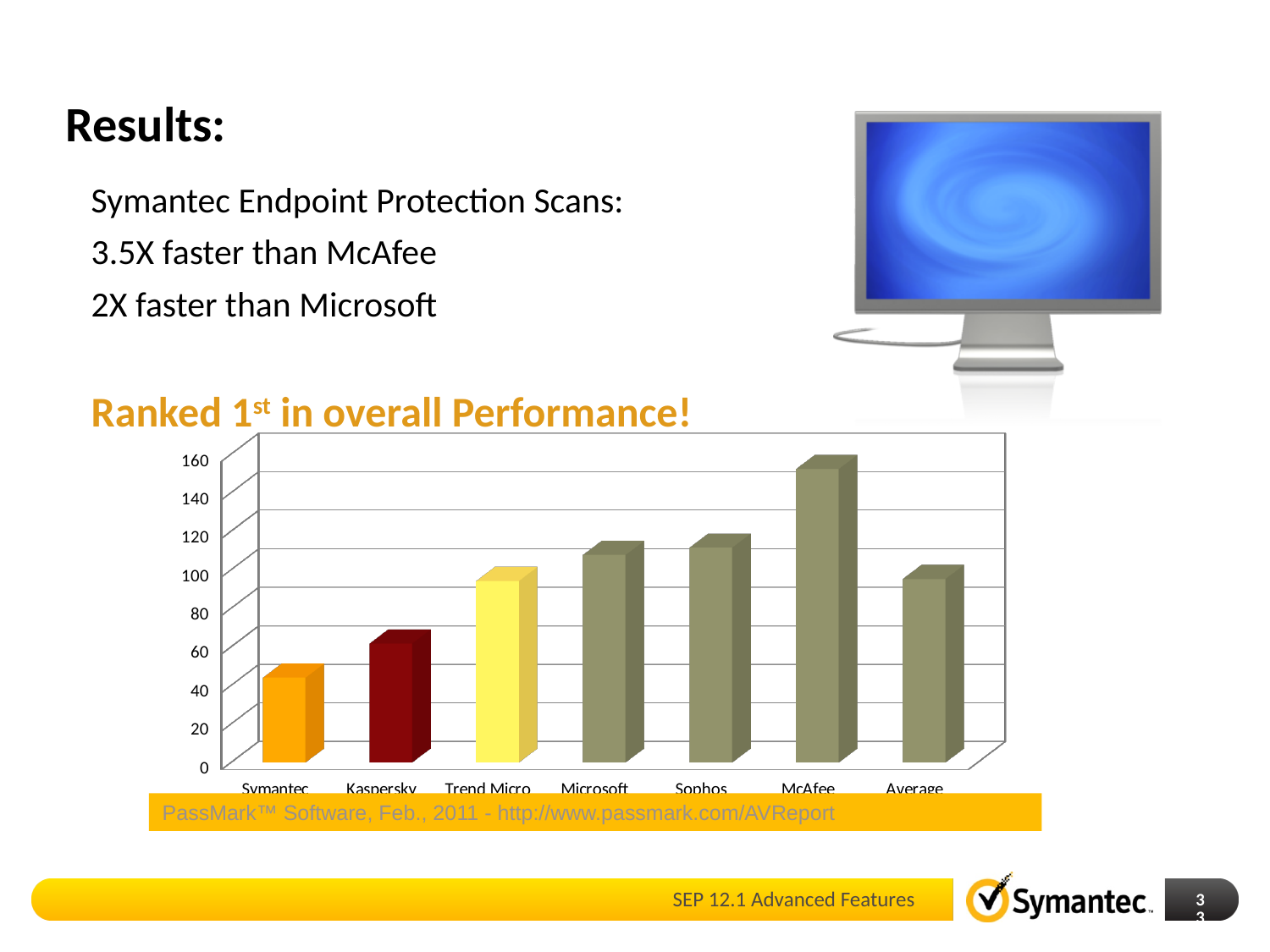
Is the value for Average greater or less than 120? less Is the value for Sophos greater or less than 100? greater Is the value for Symantec greater or less than 60? less Do the bar values rise or fall from Symantec to McAfee along the x axis? rise What kind of chart is shown on the slide? bar chart Which is larger, the value for Kaspersky or the value for Symantec? Kaspersky How many categories are plotted on the x axis of the chart? 7 Which category has the lowest bar in the chart? Symantec What colour is the Symantec bar in the chart? orange Which category has the highest bar in the chart? McAfee